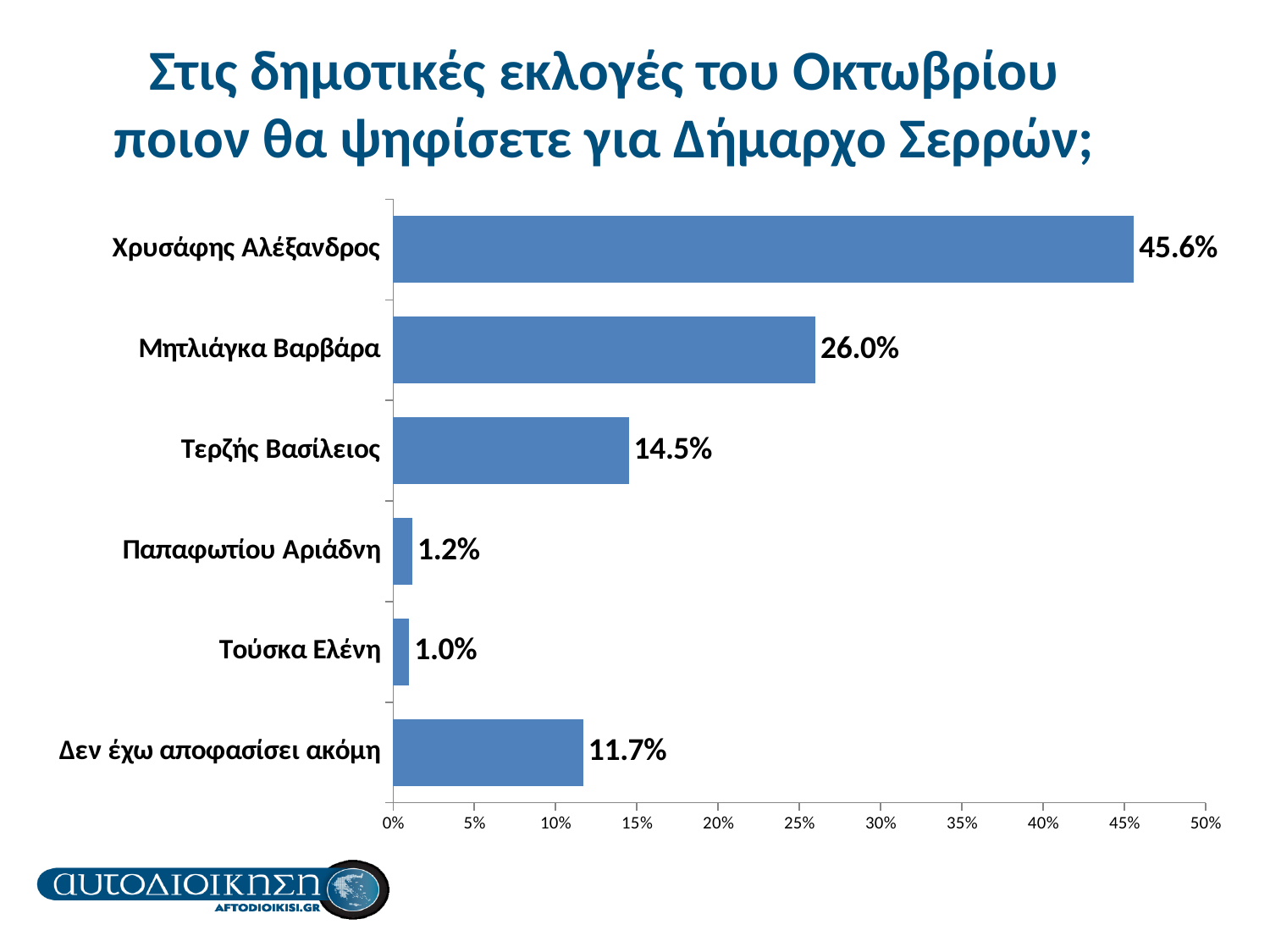
Which has a larger value, Παπαφωτίου Αριάδνη or Τούσκα Ελένη? Παπαφωτίου Αριάδνη What percentage of respondents said they would vote for Χρυσάφης Αλέξανδρος? 45.6% What is the value shown for Μητλιάγκα Βαρβάρα? 26.0% What kind of chart is shown on the slide? Bar chart What is the difference between the values for Τερζής Βασίλειος and 'Δεν έχω αποφασίσει ακόμη'? 2.8% Which category has the lowest value on the chart? Τούσκα Ελένη What is the value for 'Δεν έχω αποφασίσει ακόμη'? 11.7% What percentage is shown for Τερζής Βασίλειος? 14.5% Which category has the highest value on the chart? Χρυσάφης Αλέξανδρος What is the difference between the values for Χρυσάφης Αλέξανδρος and Μητλιάγκα Βαρβάρα? 19.6% What is the maximum value shown on the horizontal axis? 50% How many categories are shown on the chart? 6